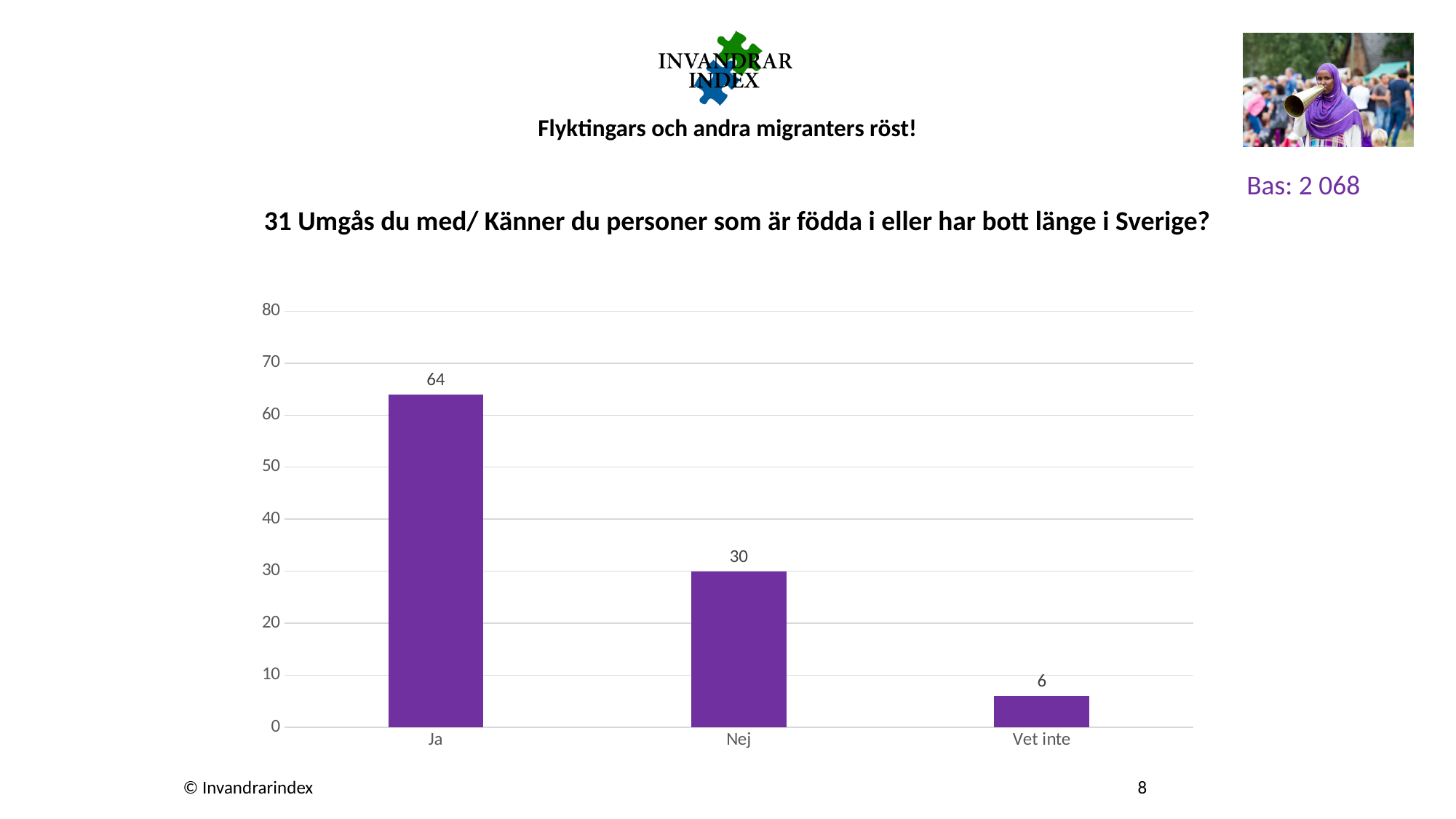
Which is larger, the value for Nej or the value for Vet inte? Nej Which category has the lowest value? Vet inte What is the title of the chart? 31 Umgås du med/ Känner du personer som är födda i eller har bott länge i Sverige? Which category has the highest value? Ja What is the value for Ja? 64 What is the value for Vet inte? 6 What kind of chart is shown on the slide? bar chart Is the value for Ja greater or less than 60? greater How many categories are shown on the x axis? 3 What is the difference between the values for Ja and Nej? 34 What is the difference between the values for Nej and Vet inte? 24 What is the value for Nej? 30